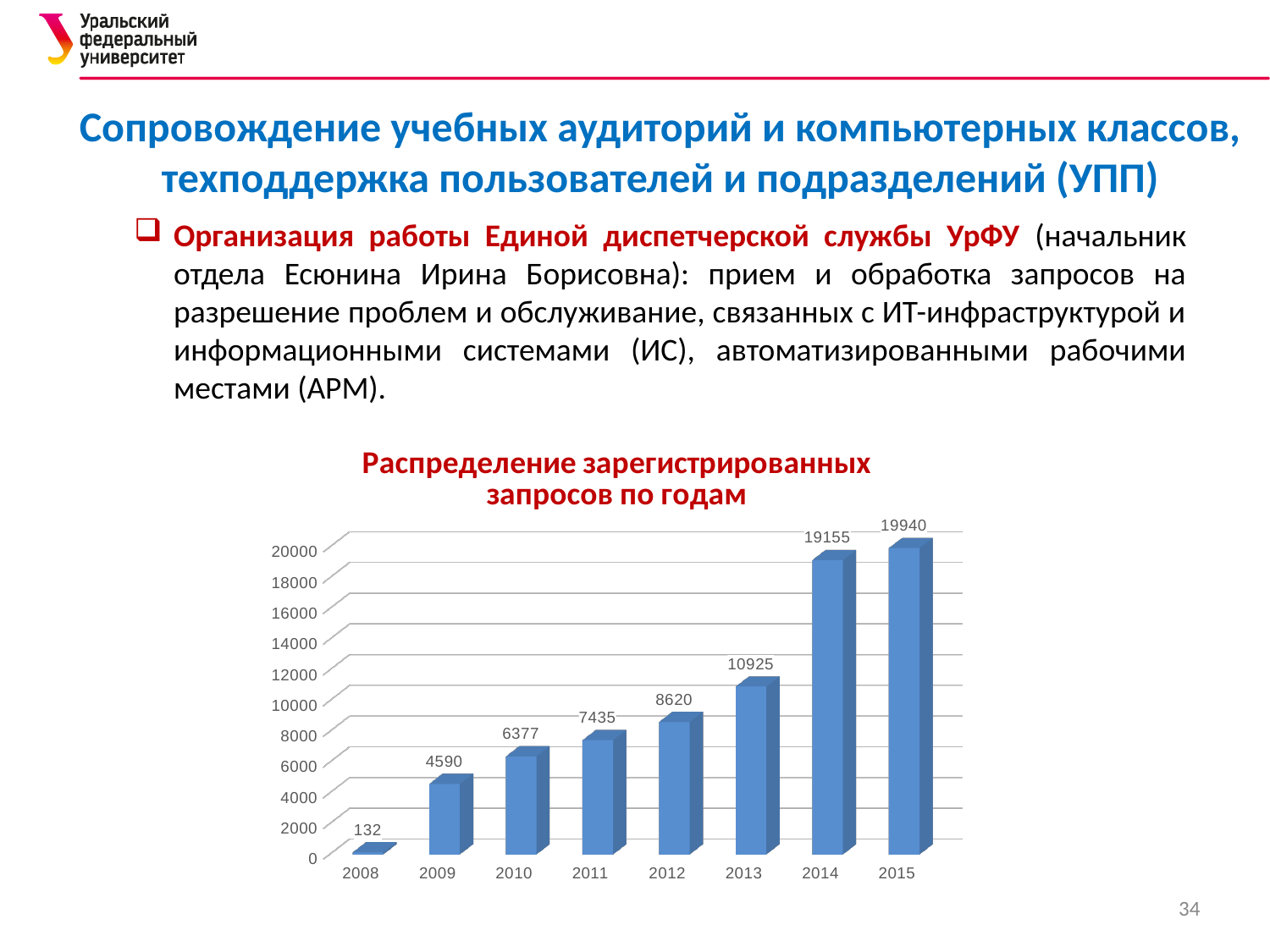
Do the values rise or fall from 2008 to 2015? rise What is the difference between the values for 2015 and 2014? 785 What is the difference between the values for 2013 and 2012? 2305 What is the value for 2012 in the chart 'Распределение зарегистрированных запросов по годам'? 8620 Which year has the lowest value in the chart? 2008 What is the value for 2008 in the chart? 132 Which year has the highest value in the chart? 2015 How many years are shown on the x axis of the chart? 8 What is the value for 2015 in the chart? 19940 Is the value for 2013 greater or less than 10000? greater Which is larger, the value for 2010 or the value for 2011? 2011 What kind of chart is shown on the slide? bar chart